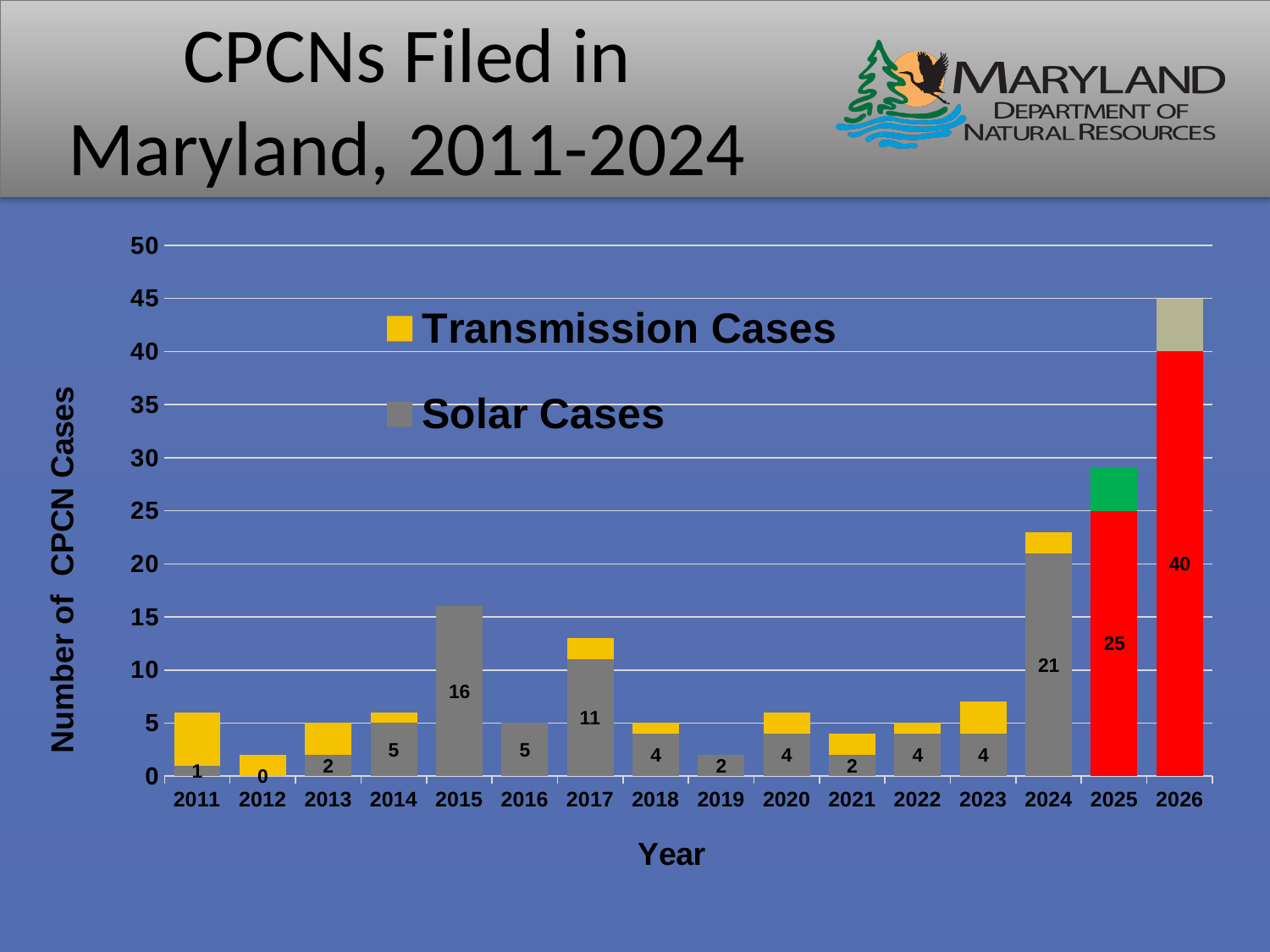
What is the number of Solar Cases in 2015? 16 What is the number of Solar Cases in 2026? 40 Which year has the highest number of Solar Cases? 2026 Is the total height of the 2024 bar greater or less than 20? greater How many years are shown on the x axis? 16 Which year has the lowest number of Solar Cases? 2012 Which year has more Solar Cases, 2017 or 2025? 2025 Do the Solar Cases rise or fall from 2023 to 2026? rise What kind of chart is shown on the slide? bar chart What is the difference in Solar Cases between 2024 and 2015? 5 What is the number of Solar Cases in 2024? 21 How many series does the legend list? 2